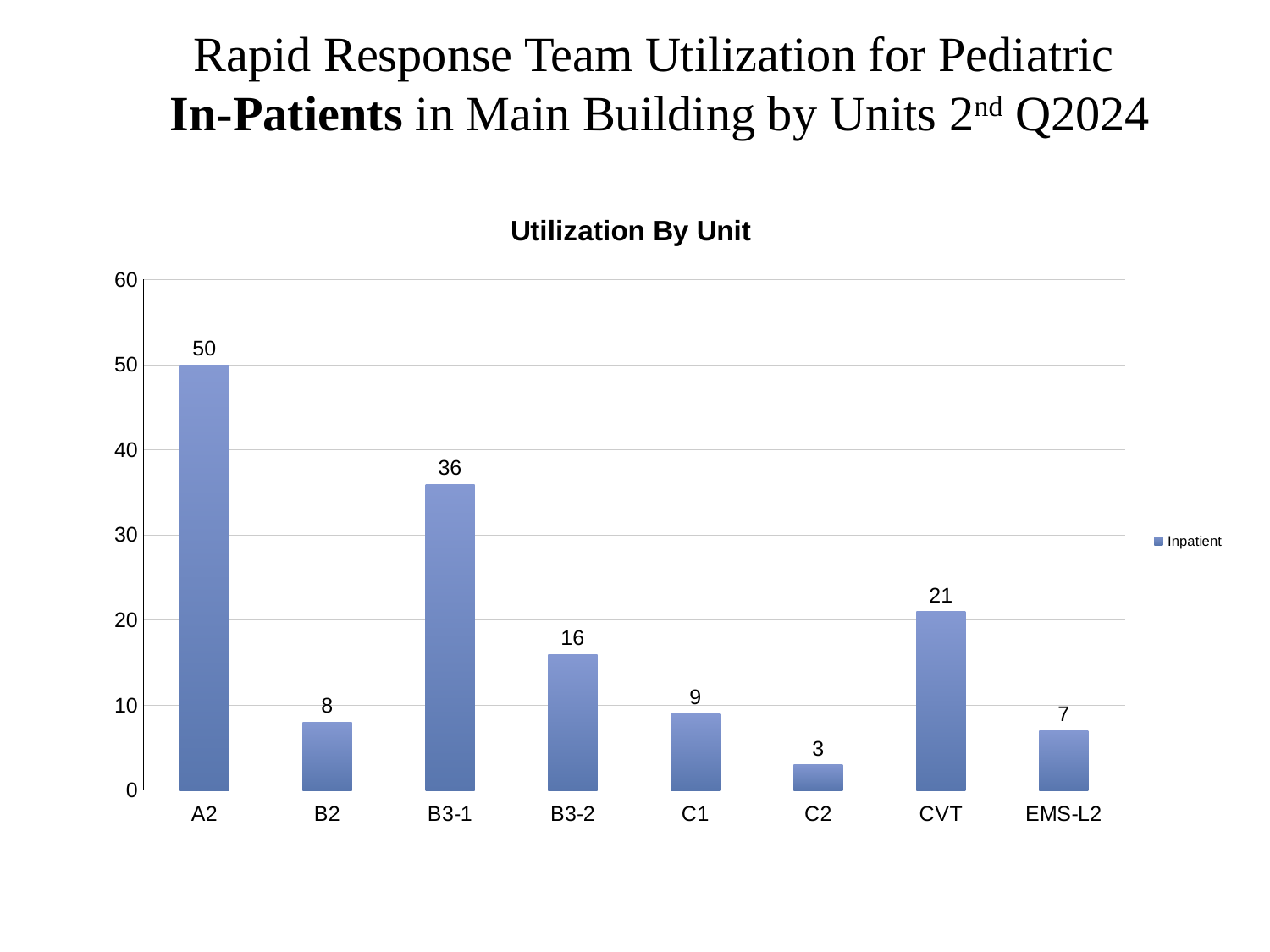
What kind of chart is this? bar chart How many units are shown on the x axis? 8 How many series does the legend list? 1 What is the value for EMS-L2? 7 What is the value for CVT? 21 What is the value for A2? 50 What is the difference between the values for CVT and B3-2? 5 What is the difference between the values for A2 and B3-1? 14 Which is larger, the value for B2 or the value for C1? C1 Is the value for B3-1 greater or less than 30? greater Which unit has the lowest value? C2 Which unit has the highest value? A2